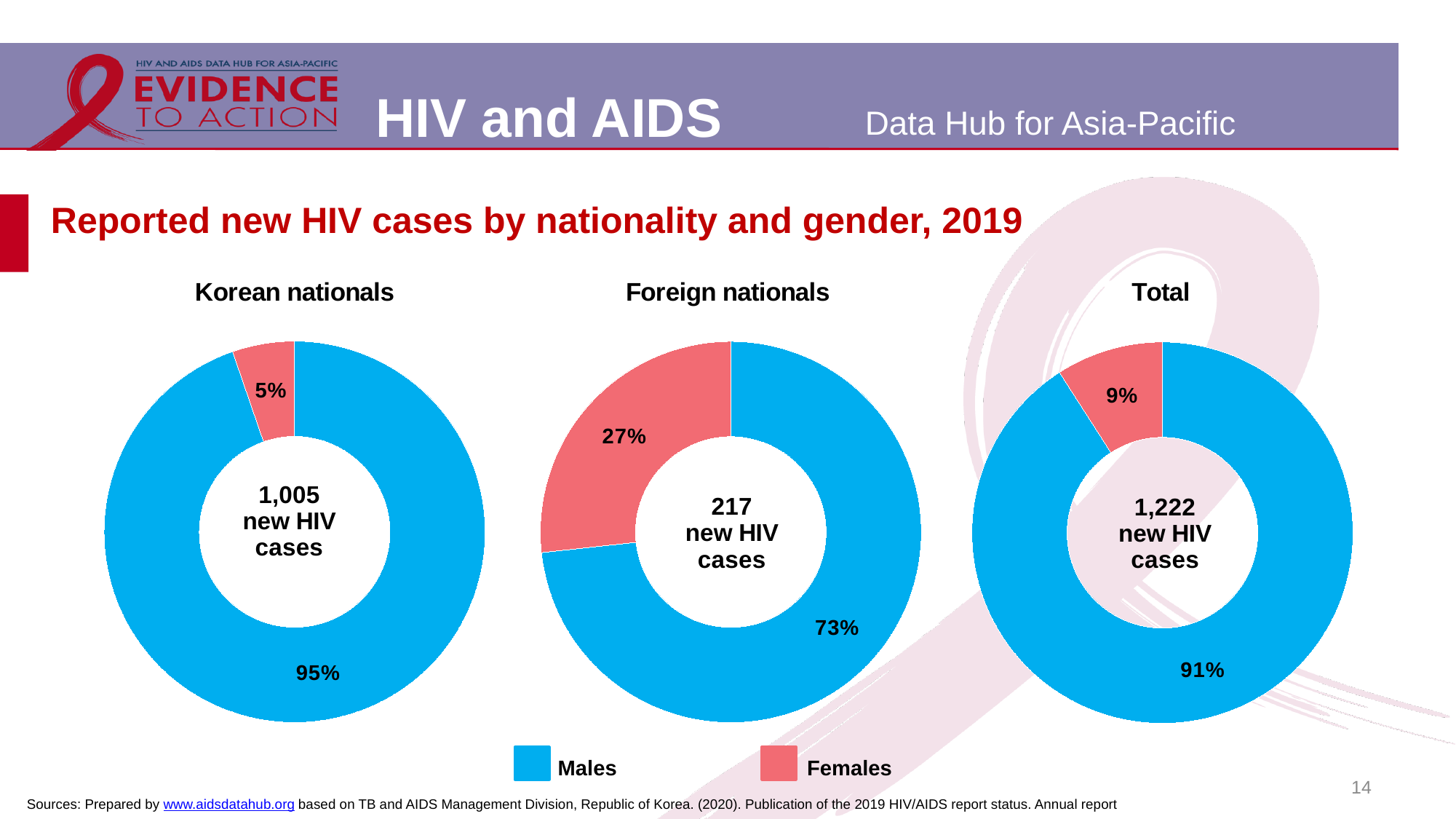
In the Foreign nationals chart, what share of new HIV cases are females? 27% In the Total chart, how many new HIV cases are shown in the centre? 1,222 new HIV cases In the Total chart, what share of new HIV cases are males? 91% In the Foreign nationals chart, what share of new HIV cases are males? 73% In the Foreign nationals chart, how many new HIV cases are shown in the centre? 217 new HIV cases What kind of chart is used for the Korean nationals data? Donut (pie) chart In the Korean nationals chart, how many new HIV cases are shown in the centre? 1,005 new HIV cases How many series does the legend list? 2 In the Foreign nationals chart, which gender has the larger share of new HIV cases? Males